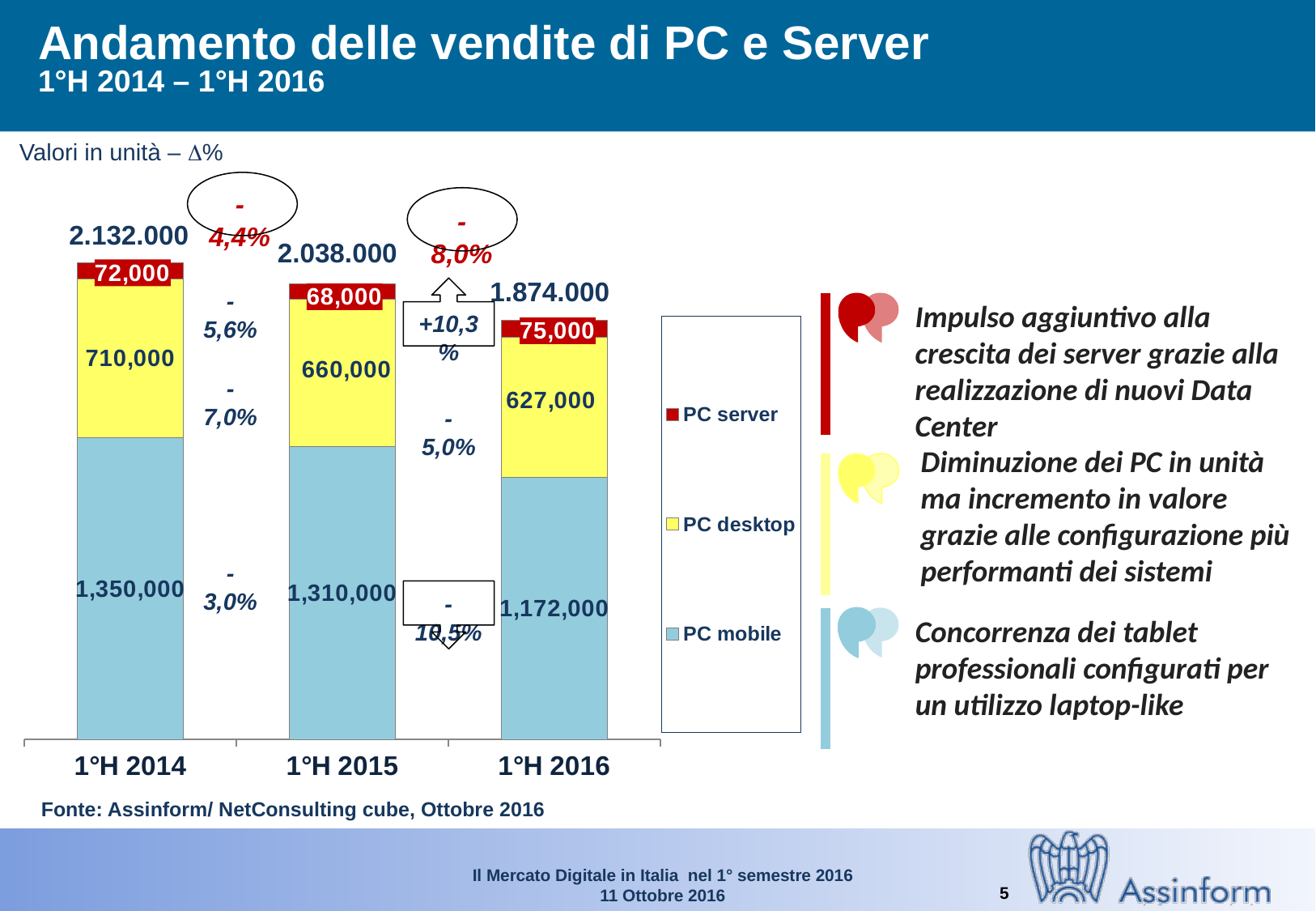
What is the value for PC desktop in 1°H 2015? 660,000 What is the difference between the PC desktop values in 1°H 2014 and 1°H 2016? 83,000 Does the total of the stacked bars rise or fall from 1°H 2014 to 1°H 2016? fall In which period is the PC server value highest? 1°H 2016 Which colour represents PC desktop in the legend? yellow What is the value for PC server in 1°H 2016? 75,000 What type of chart is shown on the slide? stacked bar chart How many series does the legend list? 3 How many periods are shown on the x axis? 3 What is the total of the stacked bar for 1°H 2016? 1.874.000 What is the value for PC mobile in 1°H 2014? 1,350,000 In which period is the PC mobile value lowest? 1°H 2016